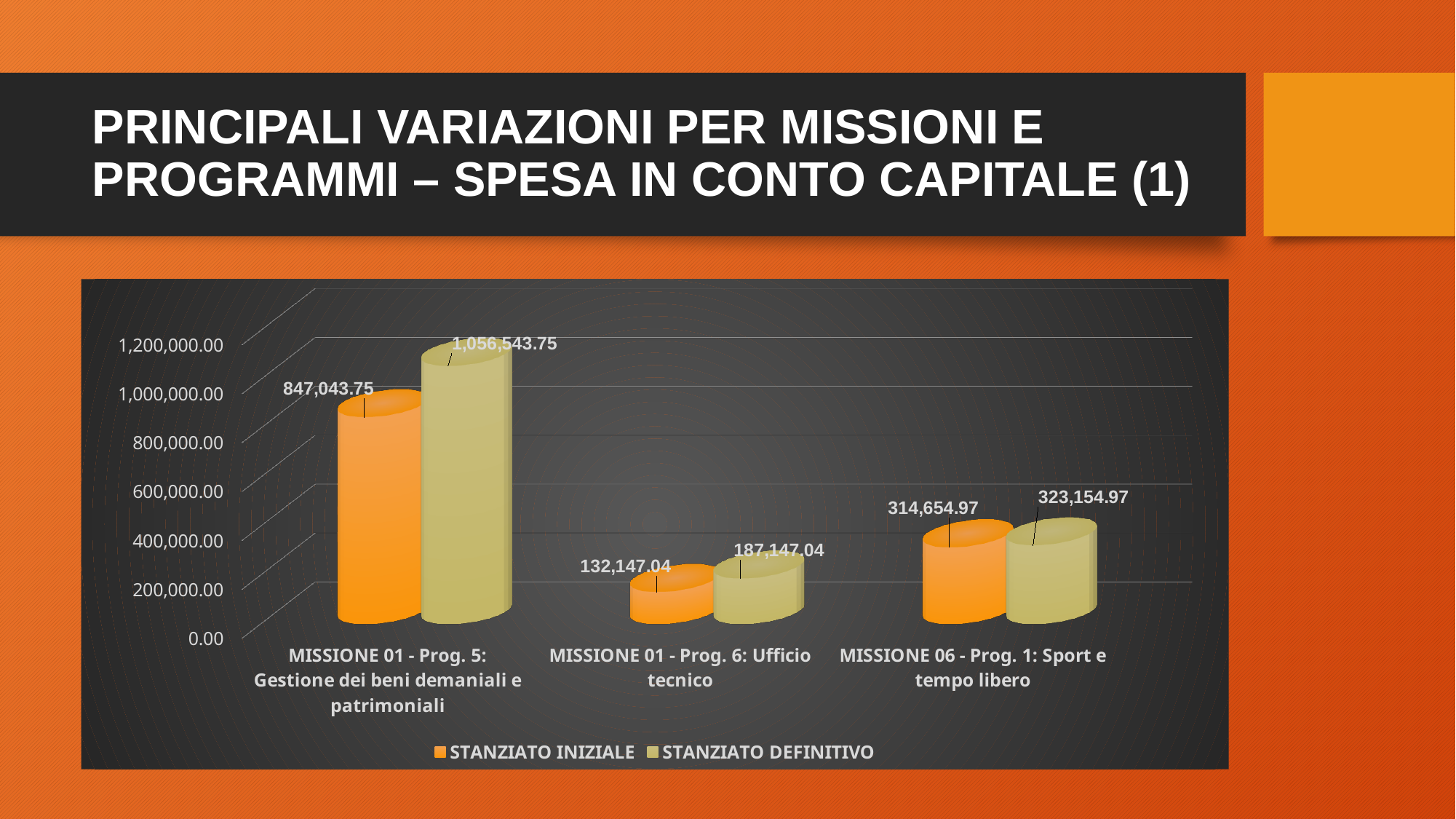
What is the STANZIATO DEFINITIVO value for MISSIONE 01 - Prog. 5: Gestione dei beni demaniali e patrimoniali? 1,056,543.75 For MISSIONE 06 - Prog. 1: Sport e tempo libero, which is larger, STANZIATO INIZIALE or STANZIATO DEFINITIVO? STANZIATO DEFINITIVO What is the STANZIATO INIZIALE value for MISSIONE 01 - Prog. 6: Ufficio tecnico? 132,147.04 What is the STANZIATO INIZIALE value for MISSIONE 01 - Prog. 5: Gestione dei beni demaniali e patrimoniali? 847,043.75 What is the STANZIATO DEFINITIVO value for MISSIONE 06 - Prog. 1: Sport e tempo libero? 323,154.97 What is the difference between STANZIATO DEFINITIVO and STANZIATO INIZIALE for MISSIONE 01 - Prog. 6: Ufficio tecnico? 55,000.00 What kind of chart is shown on the slide? Bar chart What is the difference between STANZIATO DEFINITIVO and STANZIATO INIZIALE for MISSIONE 01 - Prog. 5: Gestione dei beni demaniali e patrimoniali? 209,500.00 Which category has the lowest STANZIATO INIZIALE value? MISSIONE 01 - Prog. 6: Ufficio tecnico Which category has the highest STANZIATO DEFINITIVO value? MISSIONE 01 - Prog. 5: Gestione dei beni demaniali e patrimoniali How many categories are shown on the x axis of the chart? 3 How many series does the chart legend list? 2